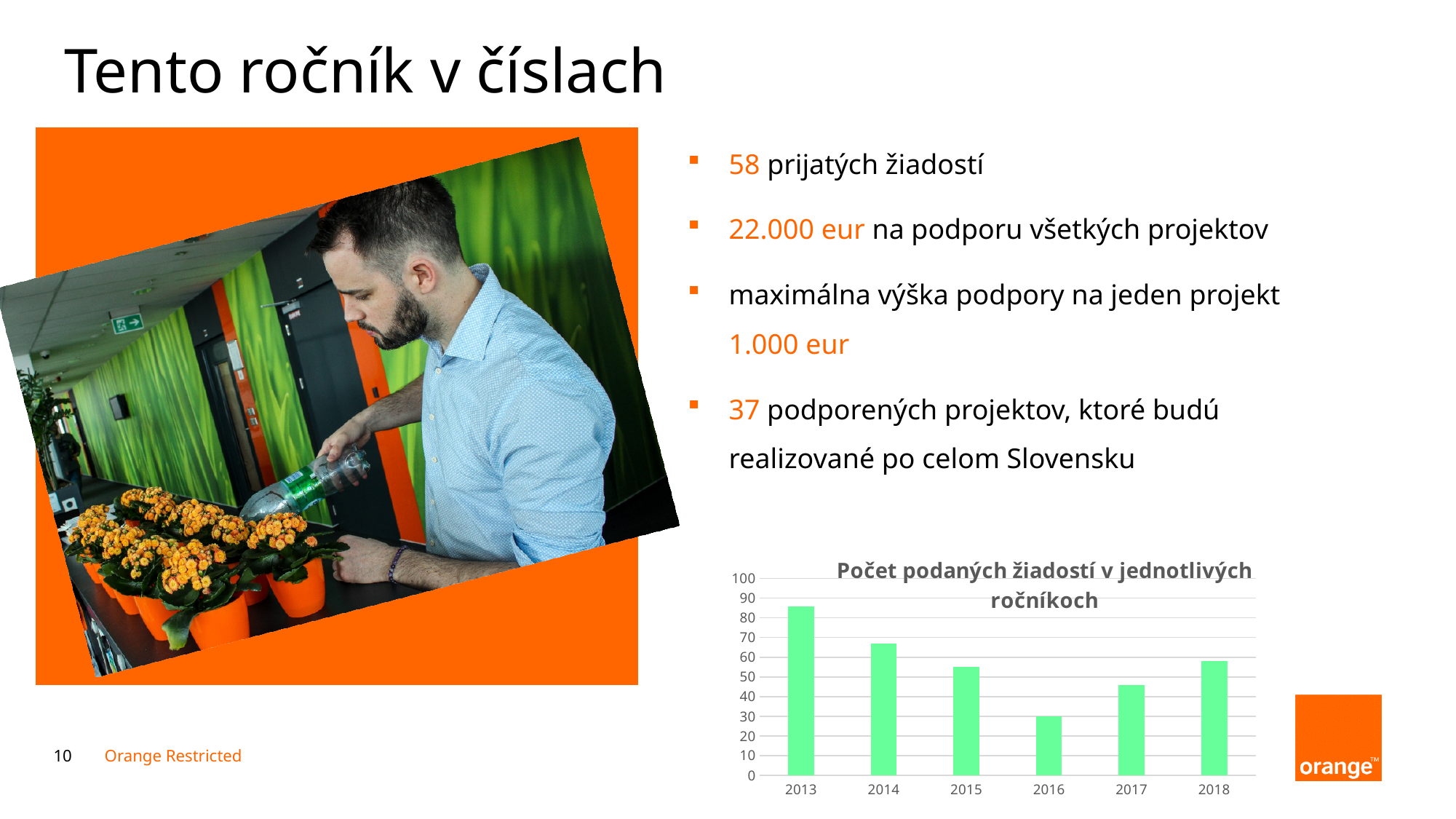
Is the value for 2017 greater or less than 50? less Is the value for 2013 greater or less than 80? greater Is the value for 2016 greater or less than 40? less Which year has the highest number of submitted applications in the chart? 2013 What kind of chart is shown on the slide? bar chart Do the values rise or fall from 2013 to 2016 in the chart? fall What is the title of the chart? Počet podaných žiadostí v jednotlivých ročníkoch How many years are shown on the x axis of the chart? 6 What colour are the bars in the chart? green Which is larger, the value for 2018 or the value for 2017? 2018 Which year has the lowest number of submitted applications in the chart? 2016